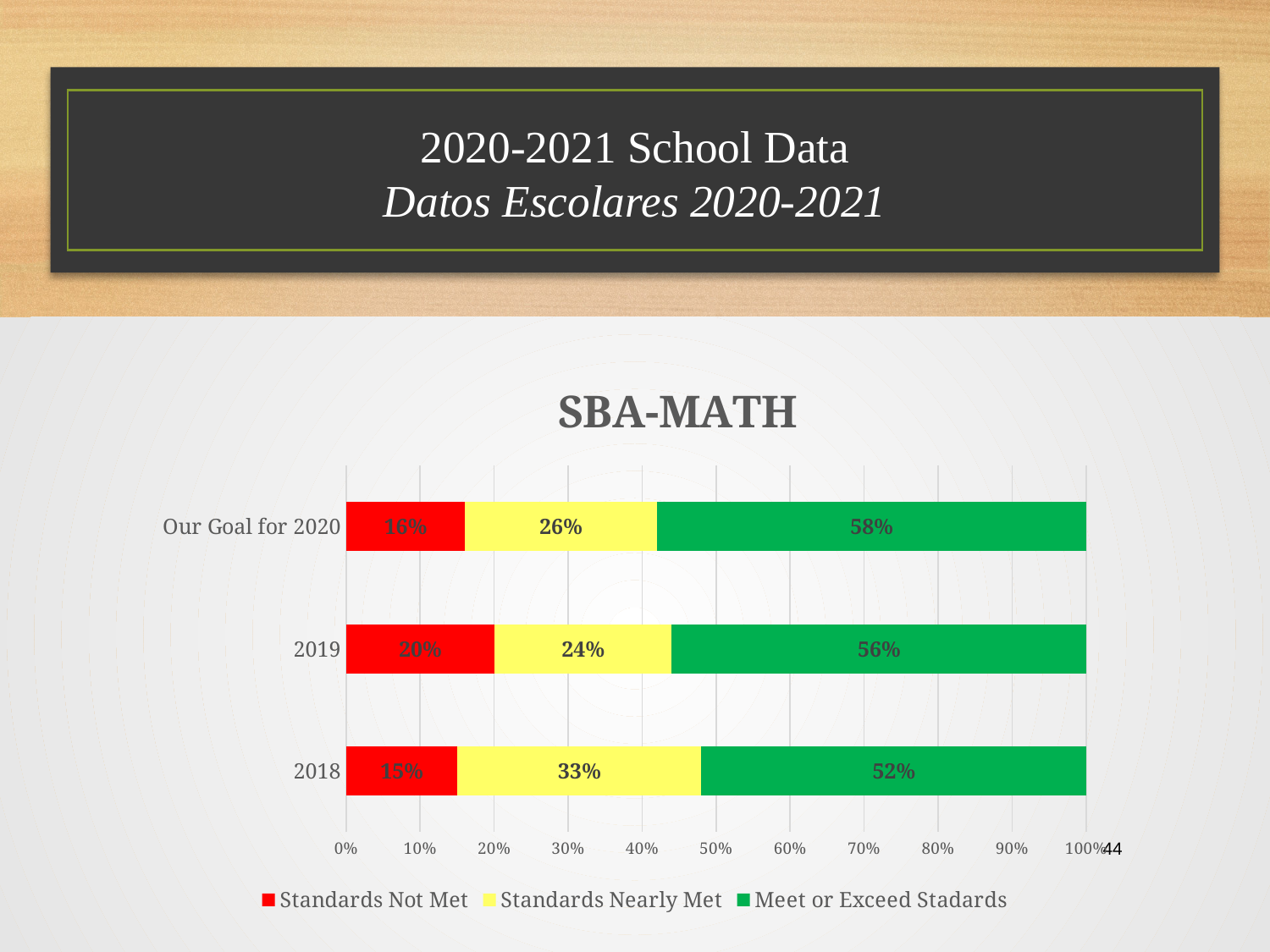
What kind of chart is shown on the slide? Stacked bar chart Which is larger: the Meet or Exceed Standards value for 2019 or for 2018? 2019 What is the Standards Nearly Met value for Our Goal for 2020? 26% What is the Meet or Exceed Standards value for 2018? 52% Which category has the lowest Standards Not Met value? 2018 What is the total of the stacked bar for 2019? 100% What is the Standards Not Met value for 2019? 20% What is the title of the chart? SBA-MATH How many categories (bars) are shown in the chart? 3 Which category has the highest Meet or Exceed Standards value? Our Goal for 2020 How many series does the legend list? 3 What is the difference between the Standards Nearly Met values for 2018 and 2019? 9%